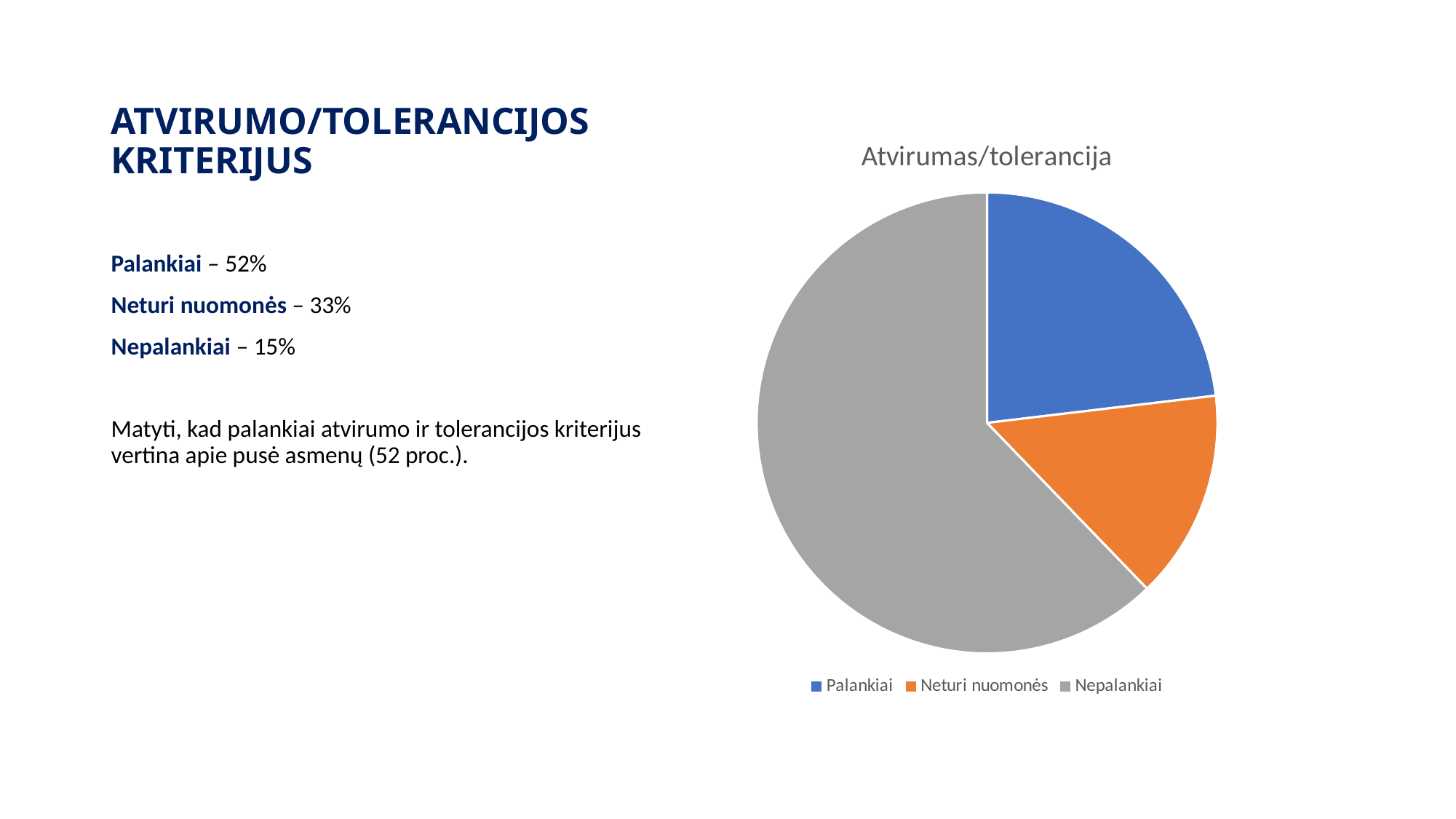
What is the title of the chart? Atvirumas/tolerancija Which slice is larger in the pie chart, Nepalankiai or Palankiai? Nepalankiai Which category has the largest slice in the pie chart? Nepalankiai Which slice is larger in the pie chart, Palankiai or Neturi nuomonės? Palankiai How many slices does the pie chart have? 3 How many entries does the chart legend list? 3 What colour is the Nepalankiai slice in the pie chart? grey Which category has the smallest slice in the pie chart? Neturi nuomonės What kind of chart is shown on the slide? pie chart